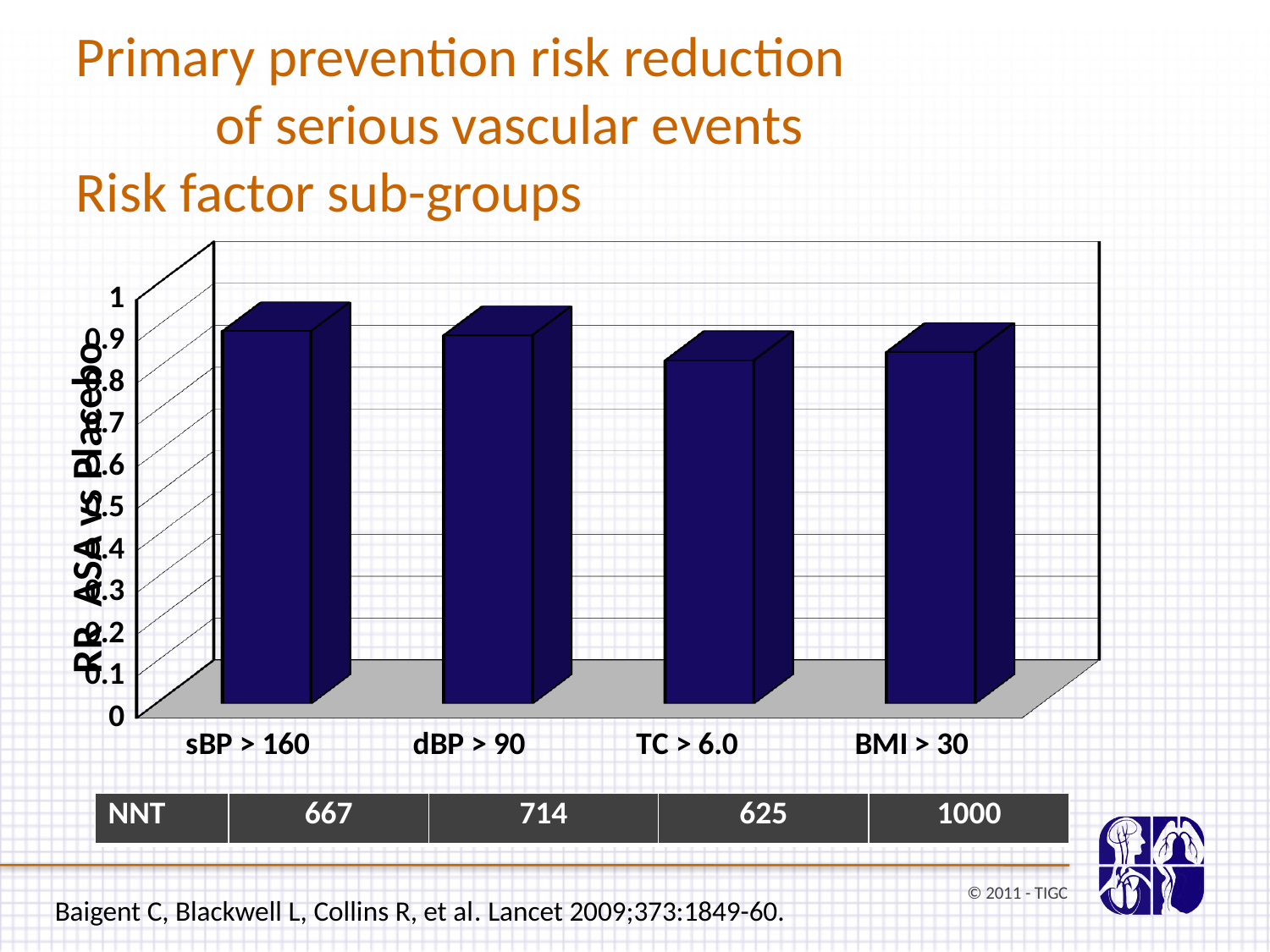
Is the value for TC > 6.0 greater or less than 0.9? less What kind of chart is shown on the slide? bar chart Is the value for sBP > 160 greater or less than 0.8? greater How many risk factor sub-groups are plotted on the chart? 4 Which risk factor sub-group has the highest bar on the chart? sBP > 160 In the NNT row below the chart, what is the difference between the NNT for BMI > 30 and the NNT for TC > 6.0? 375 Is the bar for sBP > 160 higher or lower than the bar for TC > 6.0? higher In the NNT row below the chart, what is the NNT for BMI > 30? 1000 Is the value for BMI > 30 greater or less than 0.5? greater In the NNT row below the chart, which sub-group has the lowest NNT? TC > 6.0 Which risk factor sub-group has the lowest bar on the chart? TC > 6.0 In the NNT row below the chart, what is the NNT for dBP > 90? 714